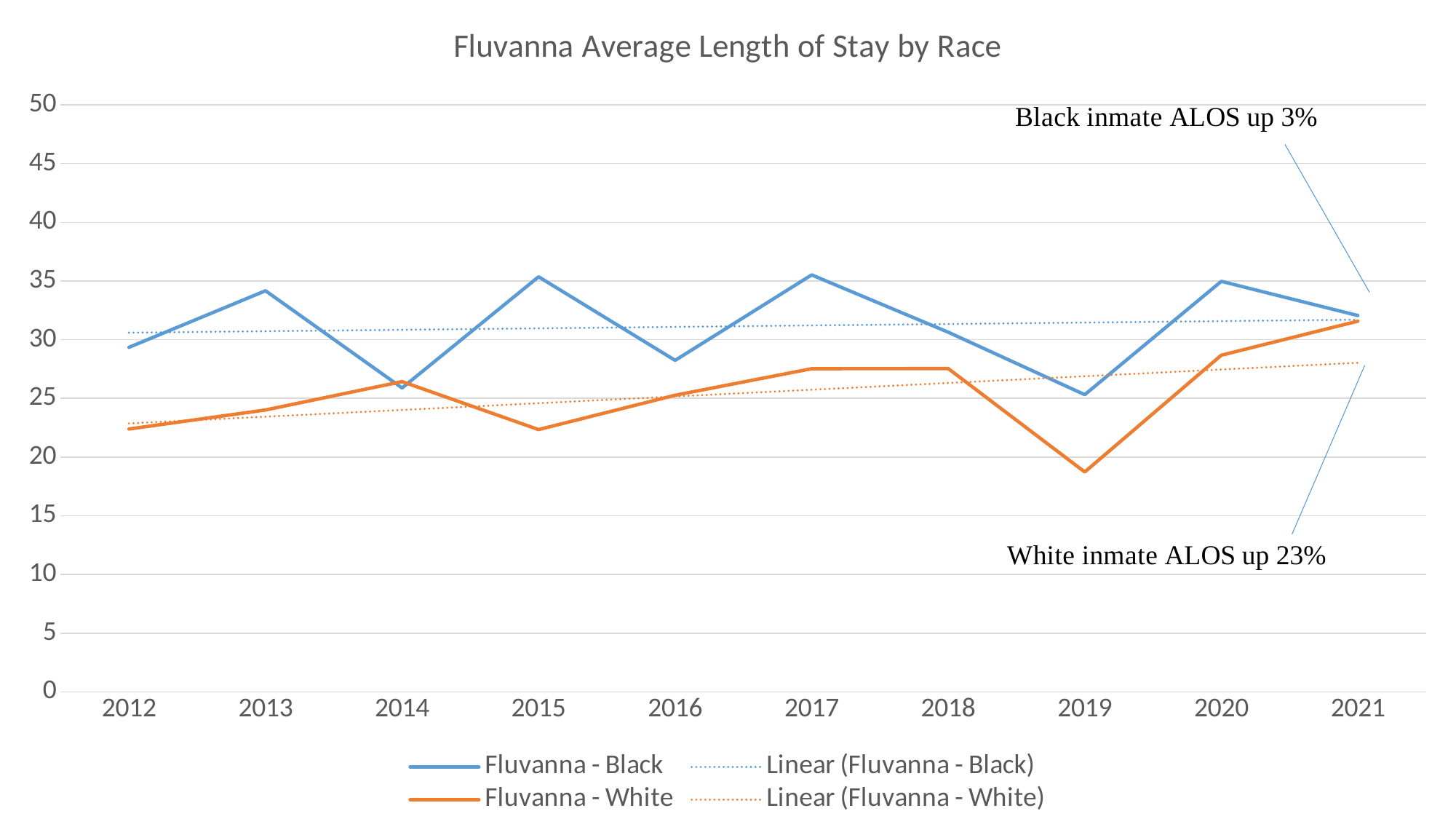
Is the Fluvanna - White value for 2019 greater or less than 20? less What is the title of the chart? Fluvanna Average Length of Stay by Race In which year is the Fluvanna - White value lowest? 2019 Is the Fluvanna - White value for 2021 greater or less than 30? greater What type of chart is shown on the slide? line chart Is the Fluvanna - White value for 2015 greater or less than 25? less How many years are plotted along the x axis? 10 How many entries does the legend list? 4 According to the annotation on the chart, by what percentage is White inmate ALOS up? 23% In which year is the Fluvanna - White value highest? 2021 In 2019, which series has the larger value, Fluvanna - Black or Fluvanna - White? Fluvanna - Black